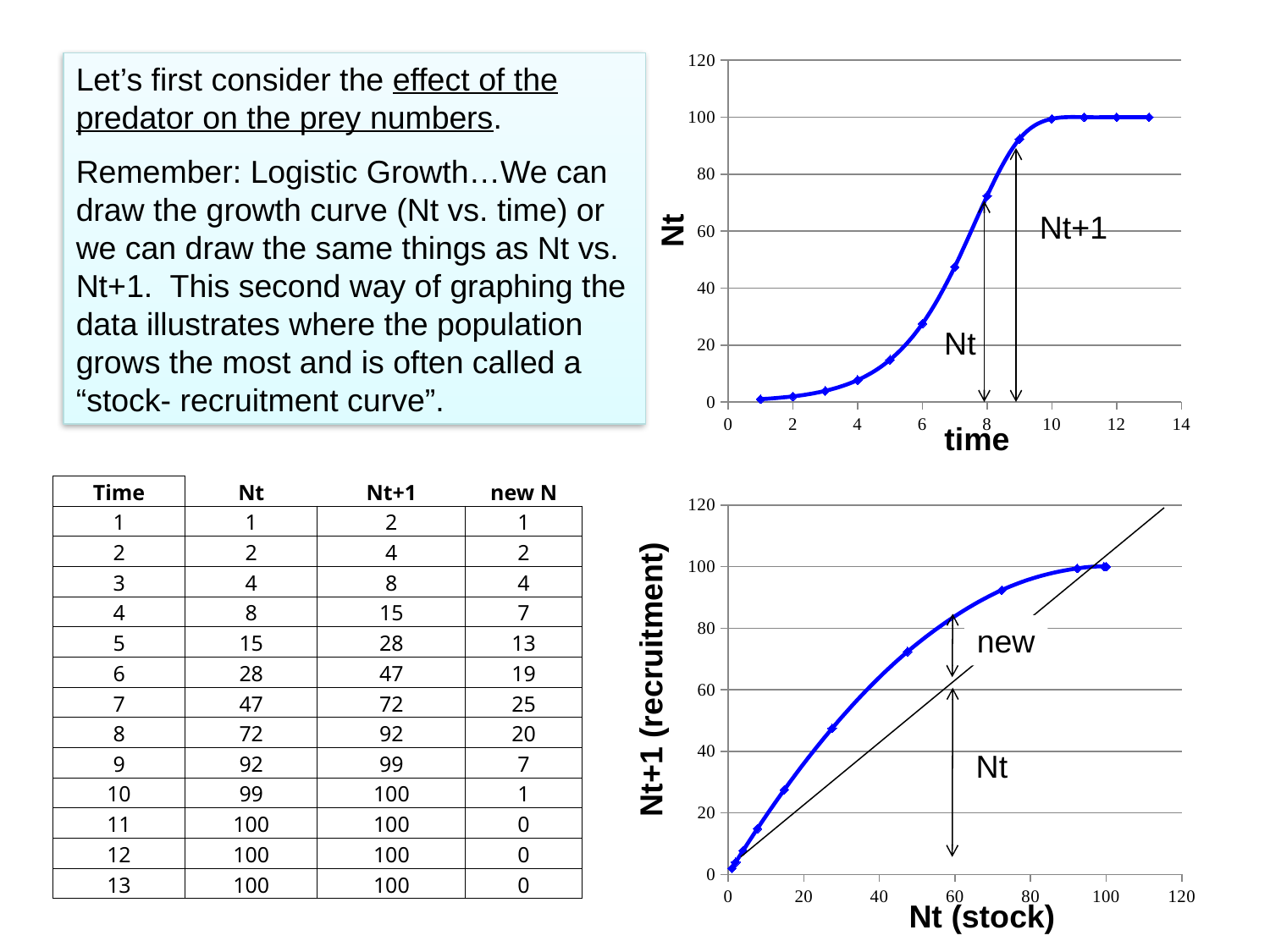
In the bottom chart (Nt+1 vs. Nt), what is the label on the y axis? Nt+1 (recruitment) In the top chart (Nt vs. time), what is the highest tick value shown on the y axis? 120 In the bottom chart (Nt+1 vs. Nt), is the value of Nt+1 at Nt = 28 greater or less than 40? greater In the top chart (Nt vs. time), is the value of Nt at time 8 greater or less than 60? greater In the bottom chart (Nt+1 vs. Nt), is the value of Nt+1 at Nt = 72 greater or less than 80? greater In the top chart (Nt vs. time), what is the highest value of Nt that the curve reaches? 100 In the top chart (Nt vs. time), how many data points are plotted? 13 What kind of chart is the top chart (Nt vs. time)? line chart In the bottom chart (Nt+1 vs. Nt), what is the highest value of Nt+1 that the curve reaches? 100 In the top chart (Nt vs. time), what is the label on the x axis? time In the top chart (Nt vs. time), do the Nt values rise or fall as time increases? rise